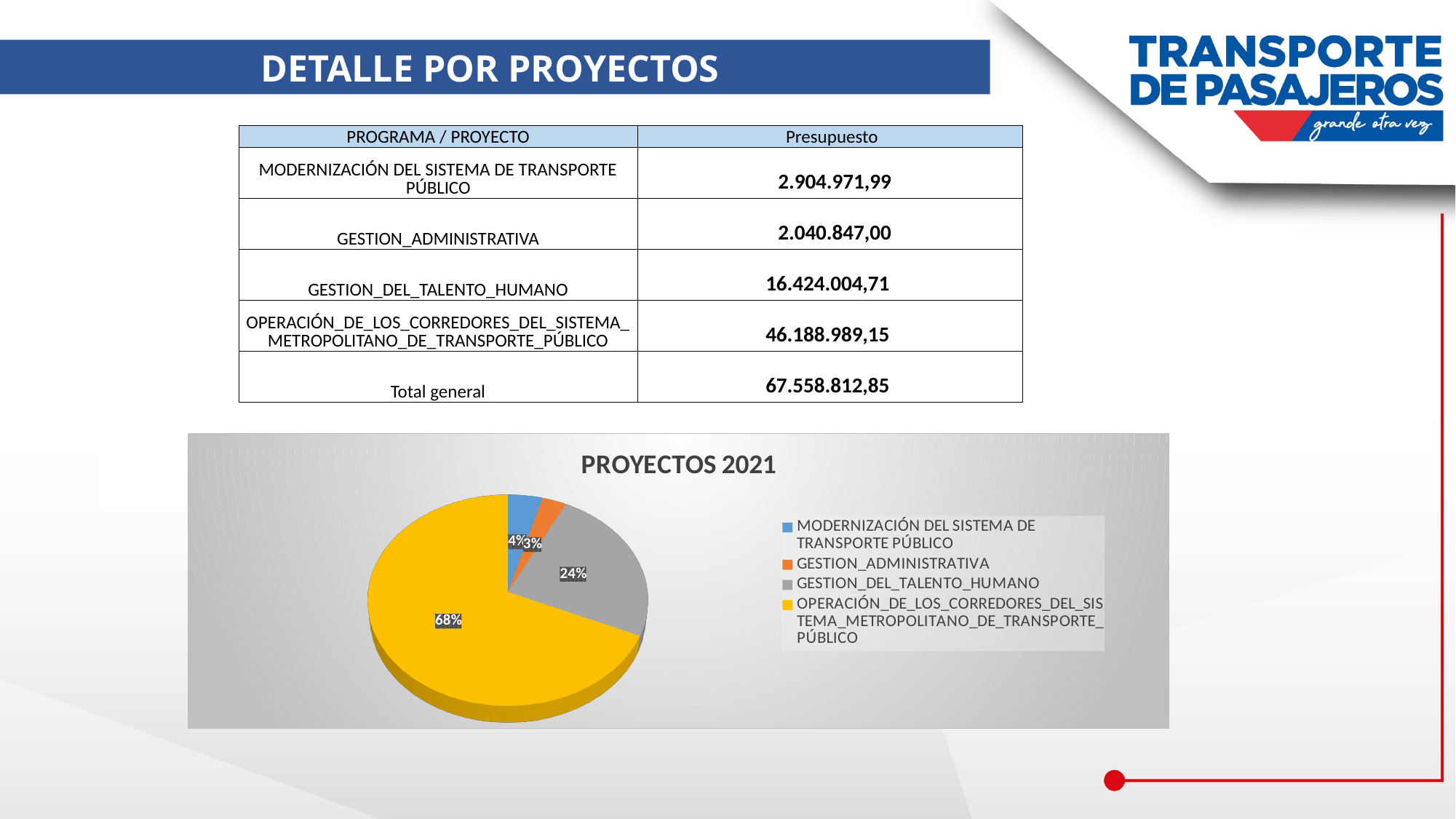
What colour is the GESTION_DEL_TALENTO_HUMANO slice in the PROYECTOS 2021 pie chart? Grey Which category has the smallest slice in the PROYECTOS 2021 pie chart? GESTION_ADMINISTRATIVA What share of the PROYECTOS 2021 pie does MODERNIZACIÓN DEL SISTEMA DE TRANSPORTE PÚBLICO represent? 4% What is the title of the pie chart? PROYECTOS 2021 What share of the PROYECTOS 2021 pie does GESTION_DEL_TALENTO_HUMANO represent? 24% In the PROYECTOS 2021 pie chart, which slice is larger: GESTION_DEL_TALENTO_HUMANO or MODERNIZACIÓN DEL SISTEMA DE TRANSPORTE PÚBLICO? GESTION_DEL_TALENTO_HUMANO How many slices does the PROYECTOS 2021 pie chart have? 4 What share of the PROYECTOS 2021 pie does OPERACIÓN_DE_LOS_CORREDORES_DEL_SISTEMA_METROPOLITANO_DE_TRANSPORTE_PÚBLICO represent? 68% In the PROYECTOS 2021 pie chart, what is the difference in percentage points between the OPERACIÓN_DE_LOS_CORREDORES slice and the GESTION_DEL_TALENTO_HUMANO slice? 44 percentage points Which category has the largest slice in the PROYECTOS 2021 pie chart? OPERACIÓN_DE_LOS_CORREDORES_DEL_SISTEMA_METROPOLITANO_DE_TRANSPORTE_PÚBLICO What kind of chart is shown under the title PROYECTOS 2021? Pie chart